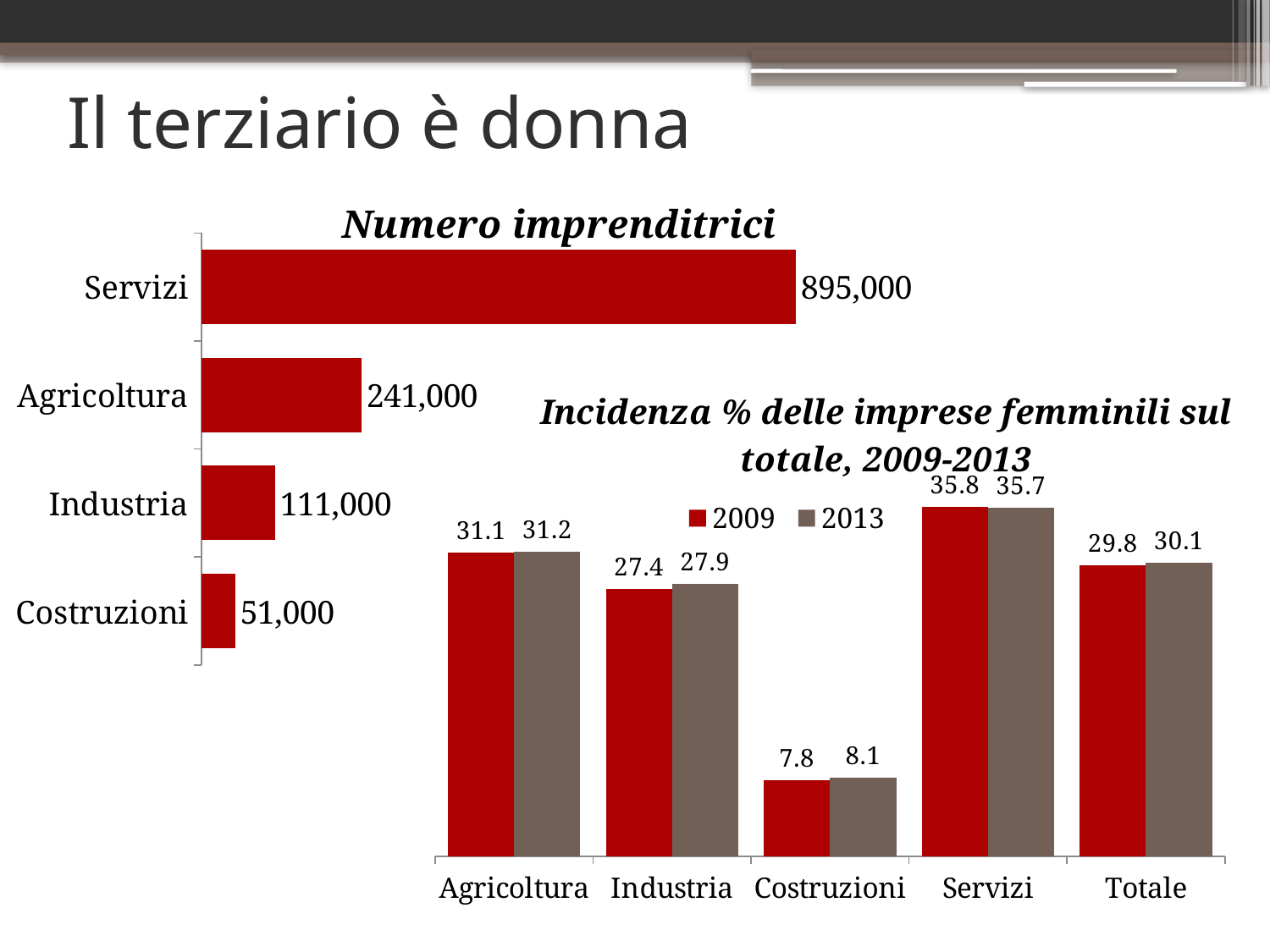
What kind of chart is the 'Numero imprenditrici' chart? Bar chart In the 'Incidenza % delle imprese femminili sul totale, 2009-2013' chart, which category has the highest value in 2013? Servizi In the 'Numero imprenditrici' chart, what is the value for Servizi? 895,000 In the 'Incidenza % delle imprese femminili sul totale, 2009-2013' chart, what is the difference between the 2013 and 2009 values for Industria? 0.5 In the 'Incidenza % delle imprese femminili sul totale, 2009-2013' chart, what is the value for Costruzioni in 2013? 8.1 In the 'Incidenza % delle imprese femminili sul totale, 2009-2013' chart, what is the value for Servizi in 2009? 35.8 In the 'Incidenza % delle imprese femminili sul totale, 2009-2013' chart, which is larger: Agricoltura in 2009 or Totale in 2013? Agricoltura in 2009 In the 'Incidenza % delle imprese femminili sul totale, 2009-2013' chart, which category has the lowest value in 2009? Costruzioni In the 'Numero imprenditrici' chart, how many categories are shown? 4 In the 'Numero imprenditrici' chart, what is the difference between Agricoltura and Industria? 130,000 In the 'Numero imprenditrici' chart, which category has the lowest value? Costruzioni In the 'Incidenza % delle imprese femminili sul totale, 2009-2013' chart, how many series does the legend list? 2